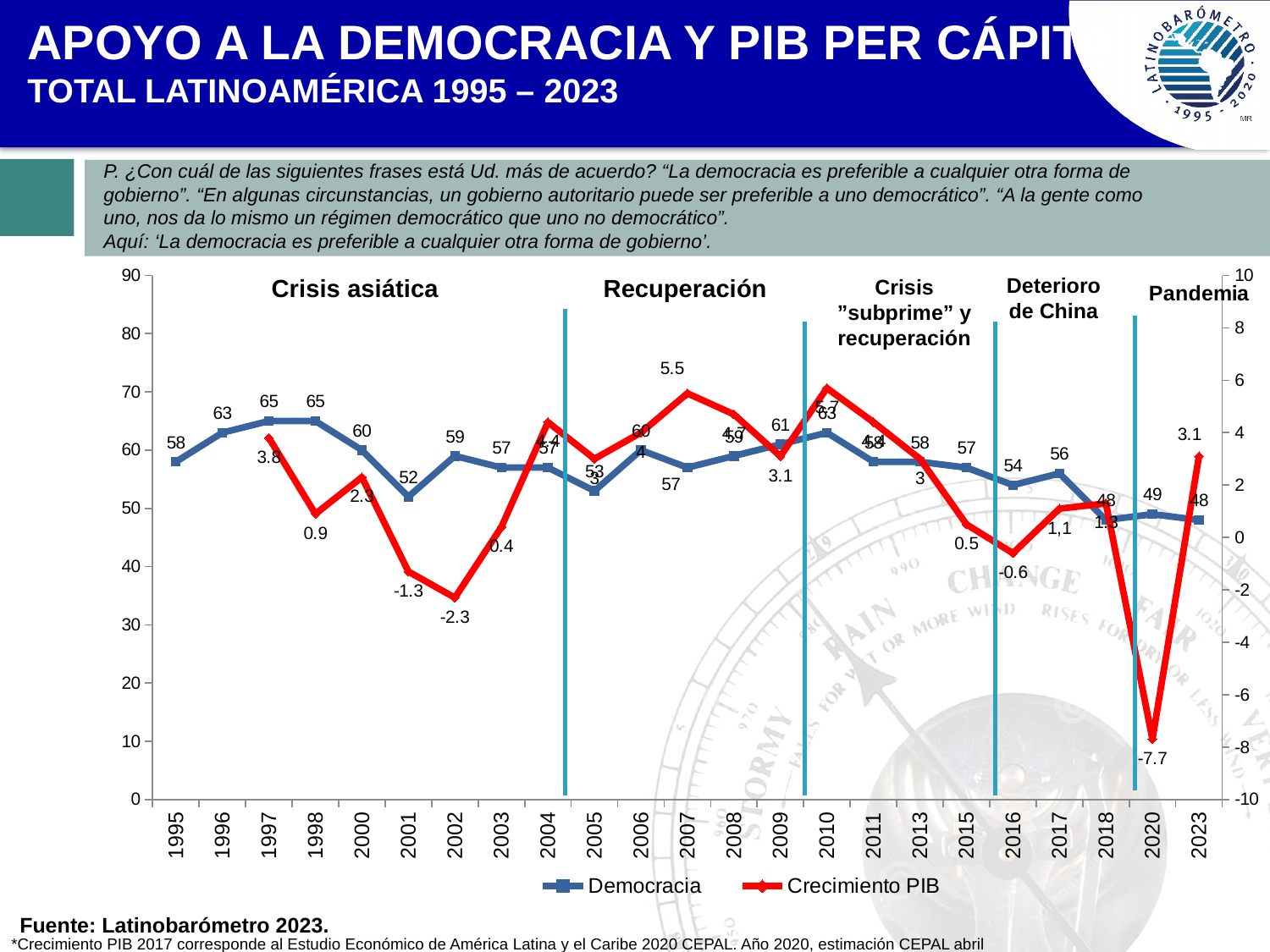
How many years are shown on the x axis? 23 In which year is the Crecimiento PIB value lowest? 2020 What is the Democracia value for 2001? 52 What is the Crecimiento PIB value for 2020? -7.7 What is the Democracia value for 1995? 58 What kind of chart is shown on the slide? line chart How many series does the legend list? 2 Does the Democracia series rise or fall from 1995 to 1998? rise Which is larger, the Democracia value for 2001 or for 2002? 2002 What is the Crecimiento PIB value for 2002? -2.3 What is the difference between the Democracia value in 1995 and in 2023? 10 What is the Crecimiento PIB value for 2007? 5.5